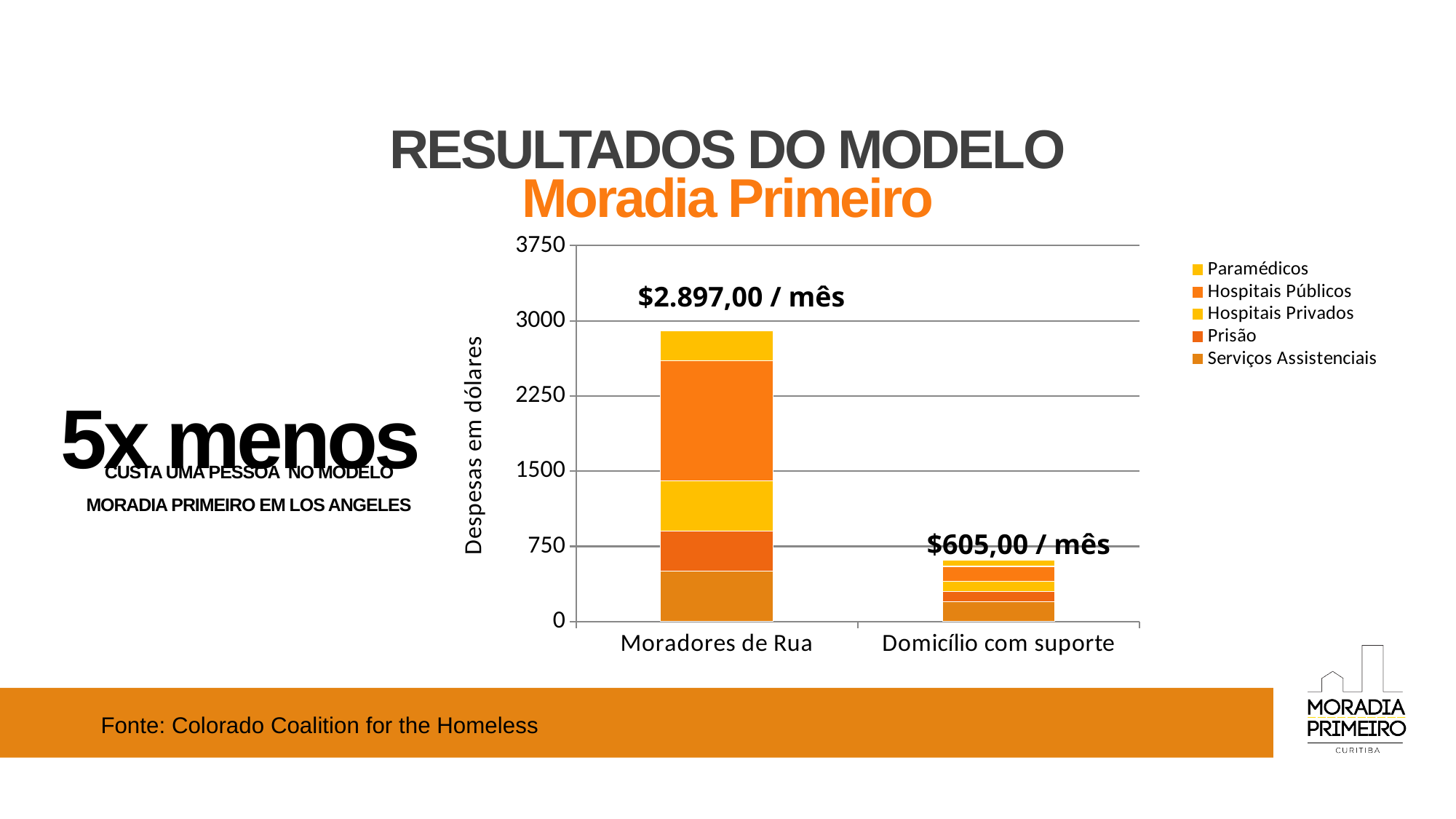
Which is larger, the total for Moradores de Rua or the total for Domicílio com suporte? Moradores de Rua What is the difference between the total for Moradores de Rua and the total for Domicílio com suporte? $2.292,00 Is the Serviços Assistenciais segment for Moradores de Rua greater or less than 750? less What is the total monthly expense shown for Domicílio com suporte? $605,00 / mês What is the title of the chart's vertical axis? Despesas em dólares Which category has the lowest total expense? Domicílio com suporte How many categories are shown on the x axis of the chart? 2 Which category has the highest total expense? Moradores de Rua What is the total monthly expense shown for Moradores de Rua? $2.897,00 / mês What kind of chart is shown on the slide? Stacked bar chart How many series does the chart's legend list? 5 Is the total value for Domicílio com suporte greater or less than 750? less